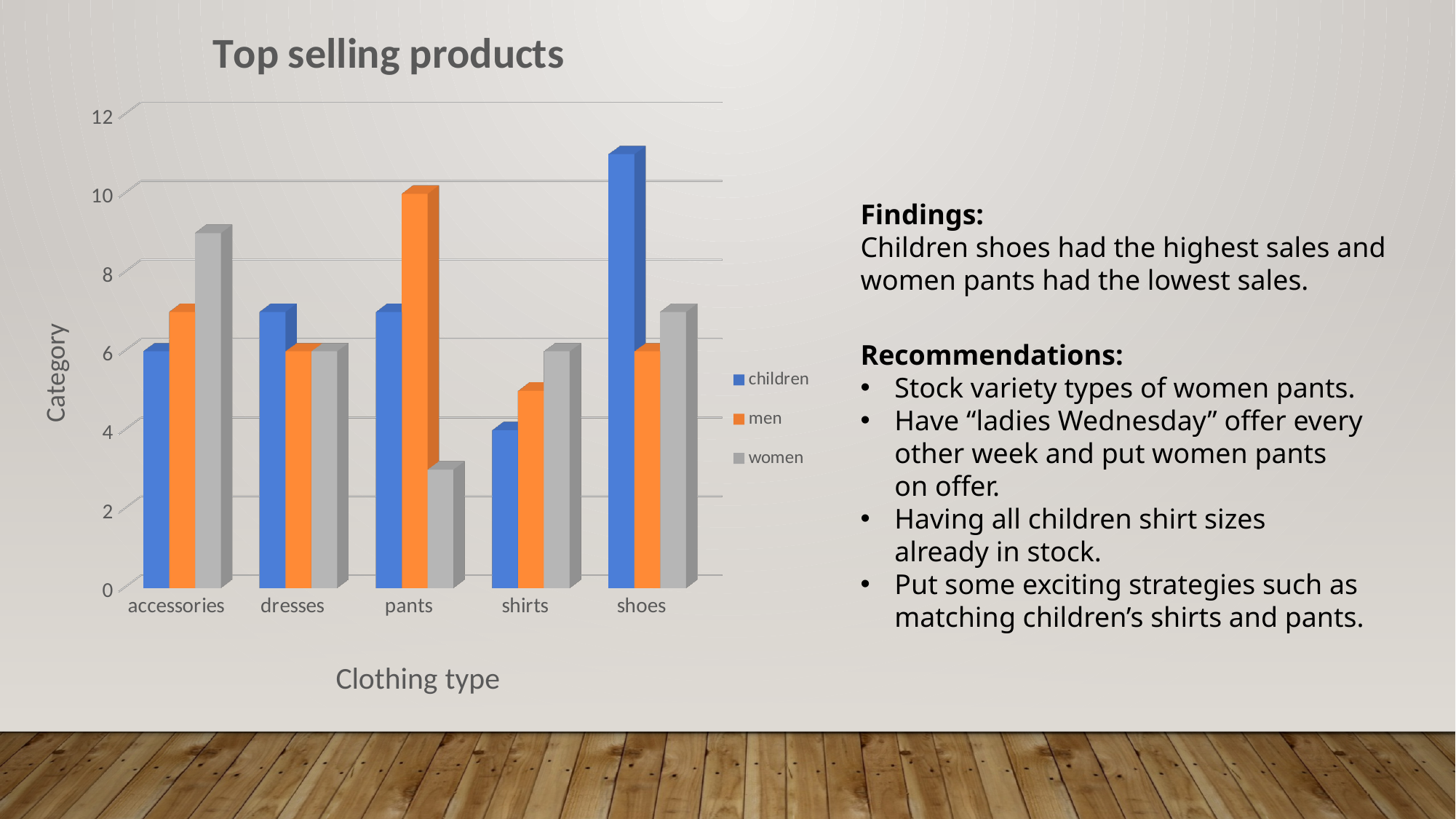
How many series does the chart's legend list? 3 Is the value for children shoes greater or less than 10? greater How many clothing types are shown on the x axis of the chart? 5 Is the value for women pants greater or less than 4? less Which clothing type has the highest value for the children series? shoes For pants, which is larger: the men value or the women value? men Is the value for men pants greater or less than 8? greater For accessories, which is larger: the women value or the children value? women What is the title of the chart's x axis? Clothing type What kind of chart is shown on the slide? bar chart Which clothing type has the lowest value for the women series? pants